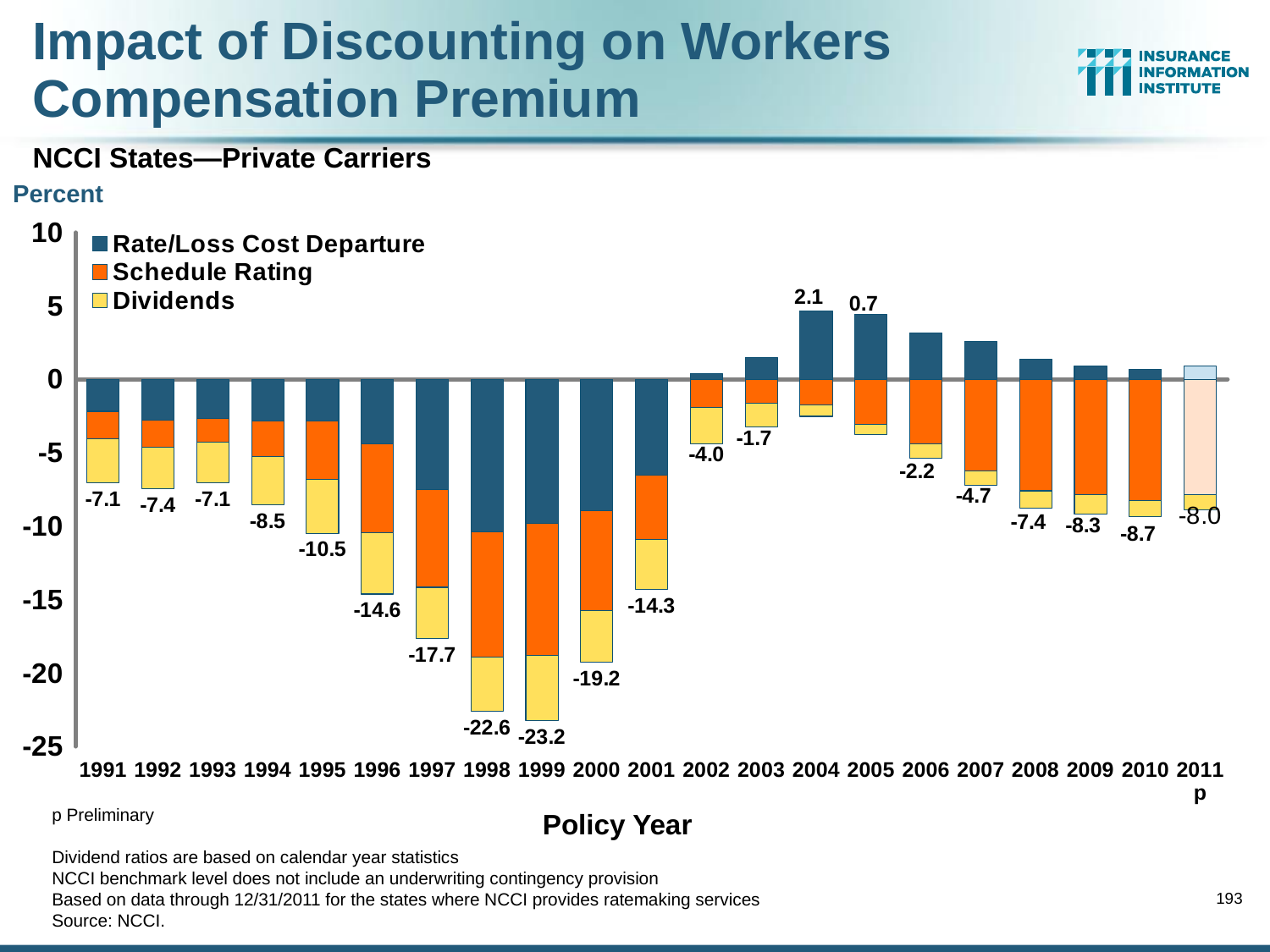
What is the difference between the total values for 2004 and 2005? 1.4 What type of chart is shown on the slide? Stacked bar chart What is the total labeled value for policy year 2004? 2.1 How many series does the legend list? 3 What is the total labeled value for policy year 1999? -23.2 Which policy year has the lowest (most negative) total value? 1999 What is the difference between the total values for 1998 and 1999? 0.6 How many policy years are shown on the x axis? 21 What is the title of the x axis? Policy Year Which policy year has the highest total value? 2004 Which policy year has a larger total value, 1997 or 2000? 1997 What is the total labeled value for policy year 2011p? -8.0